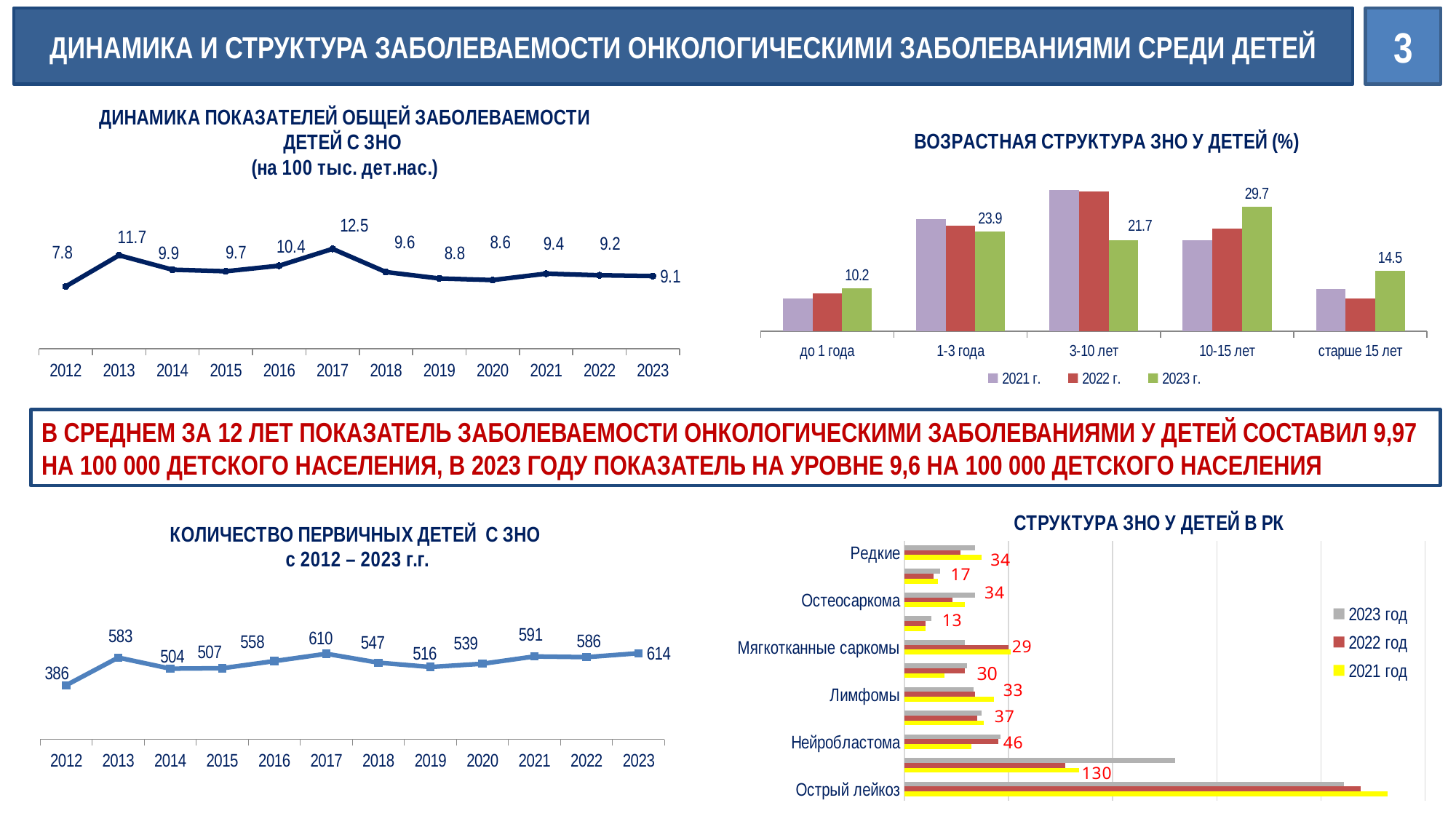
In the top-right chart 'ВОЗРАСТНАЯ СТРУКТУРА ЗНО У ДЕТЕЙ (%)', what is the 2023 г. value for 'до 1 года'? 10.2 How many series does the legend list in the top-right chart 'ВОЗРАСТНАЯ СТРУКТУРА ЗНО У ДЕТЕЙ (%)'? 3 In the top-left chart 'ДИНАМИКА ПОКАЗАТЕЛЕЙ ОБЩЕЙ ЗАБОЛЕВАЕМОСТИ ДЕТЕЙ С ЗНО', what is the difference between the values for 2013 and 2012? 3.9 In the top-right chart 'ВОЗРАСТНАЯ СТРУКТУРА ЗНО У ДЕТЕЙ (%)', what is the 2023 г. value for '10-15 лет'? 29.7 In the top-left chart 'ДИНАМИКА ПОКАЗАТЕЛЕЙ ОБЩЕЙ ЗАБОЛЕВАЕМОСТИ ДЕТЕЙ С ЗНО', what is the value for 2017? 12.5 In the bottom-left chart 'КОЛИЧЕСТВО ПЕРВИЧНЫХ ДЕТЕЙ С ЗНО', which is larger, the value for 2013 or the value for 2014? 2013 What kind of chart is the top-right chart 'ВОЗРАСТНАЯ СТРУКТУРА ЗНО У ДЕТЕЙ (%)'? Bar chart In the bottom-left chart 'КОЛИЧЕСТВО ПЕРВИЧНЫХ ДЕТЕЙ С ЗНО', what is the value for 2023? 614 In the bottom-left chart 'КОЛИЧЕСТВО ПЕРВИЧНЫХ ДЕТЕЙ С ЗНО', which year has the highest value? 2023 How many years are plotted in the top-left chart 'ДИНАМИКА ПОКАЗАТЕЛЕЙ ОБЩЕЙ ЗАБОЛЕВАЕМОСТИ ДЕТЕЙ С ЗНО'? 12 In the top-left chart 'ДИНАМИКА ПОКАЗАТЕЛЕЙ ОБЩЕЙ ЗАБОЛЕВАЕМОСТИ ДЕТЕЙ С ЗНО', which year has the lowest value? 2012 How many series does the legend list in the bottom-right chart 'СТРУКТУРА ЗНО У ДЕТЕЙ В РК'? 3